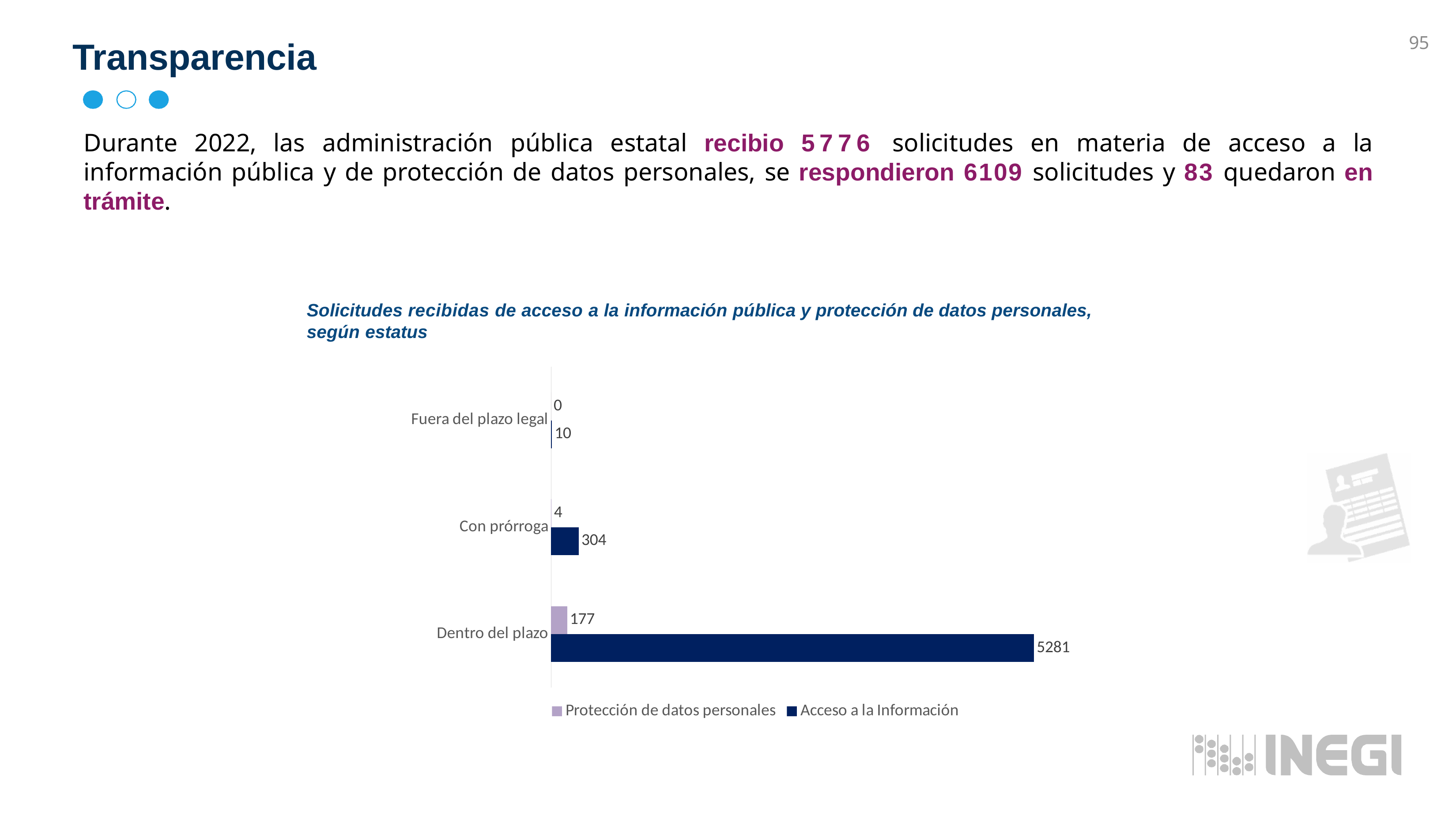
What is the difference between Acceso a la Información and Protección de datos personales in the Dentro del plazo category? 5104 Which is larger in the Con prórroga category: Acceso a la Información or Protección de datos personales? Acceso a la Información Which category has the highest value for Acceso a la Información? Dentro del plazo What is the value for Acceso a la Información in the Con prórroga category? 304 What is the value for Acceso a la Información in the Dentro del plazo category? 5281 How many categories are shown on the chart? 3 What is the value for Protección de datos personales in the Dentro del plazo category? 177 What is the value for Protección de datos personales in the Fuera del plazo legal category? 0 What is the value for Acceso a la Información in the Fuera del plazo legal category? 10 How many series does the legend list? 2 Which category has the lowest value for Protección de datos personales? Fuera del plazo legal What is the value for Protección de datos personales in the Con prórroga category? 4